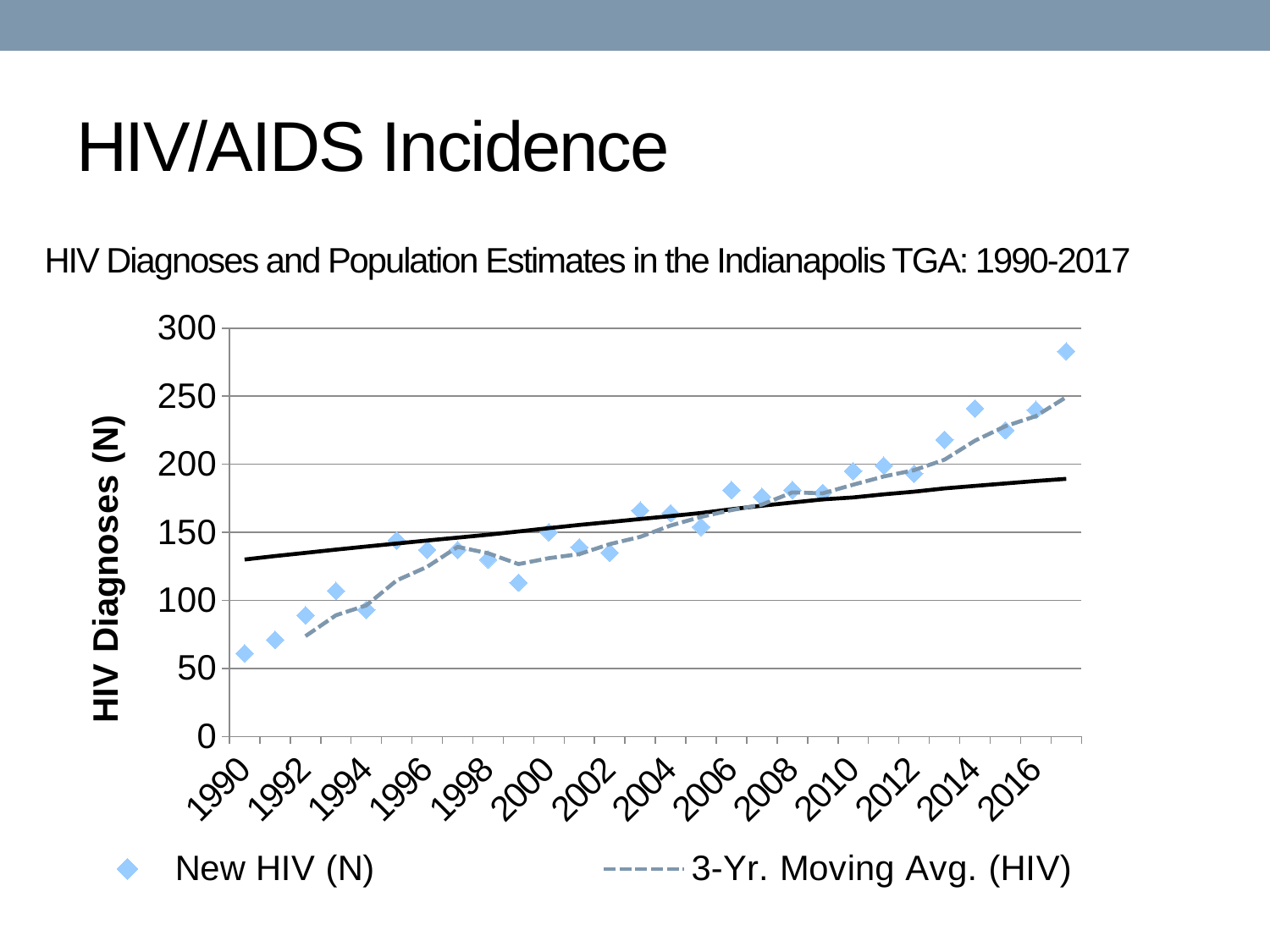
What is the title of the chart? HIV Diagnoses and Population Estimates in the Indianapolis TGA: 1990-2017 How many series does the chart legend list? 2 Is the New HIV (N) value for 1990 greater or less than 100? less Is the New HIV (N) value for 1999 greater or less than 150? less Is the New HIV (N) value for 2017 greater or less than 250? greater Which year has the lowest New HIV (N) value? 1990 Which year has the larger New HIV (N) value, 1992 or 2010? 2010 Do the New HIV (N) values generally rise or fall from 1990 to 2017? rise What kind of chart is shown on the slide? Line chart (scatter points with a moving-average line) What is the label on the vertical axis of the chart? HIV Diagnoses (N) Which year has the highest New HIV (N) value? 2017